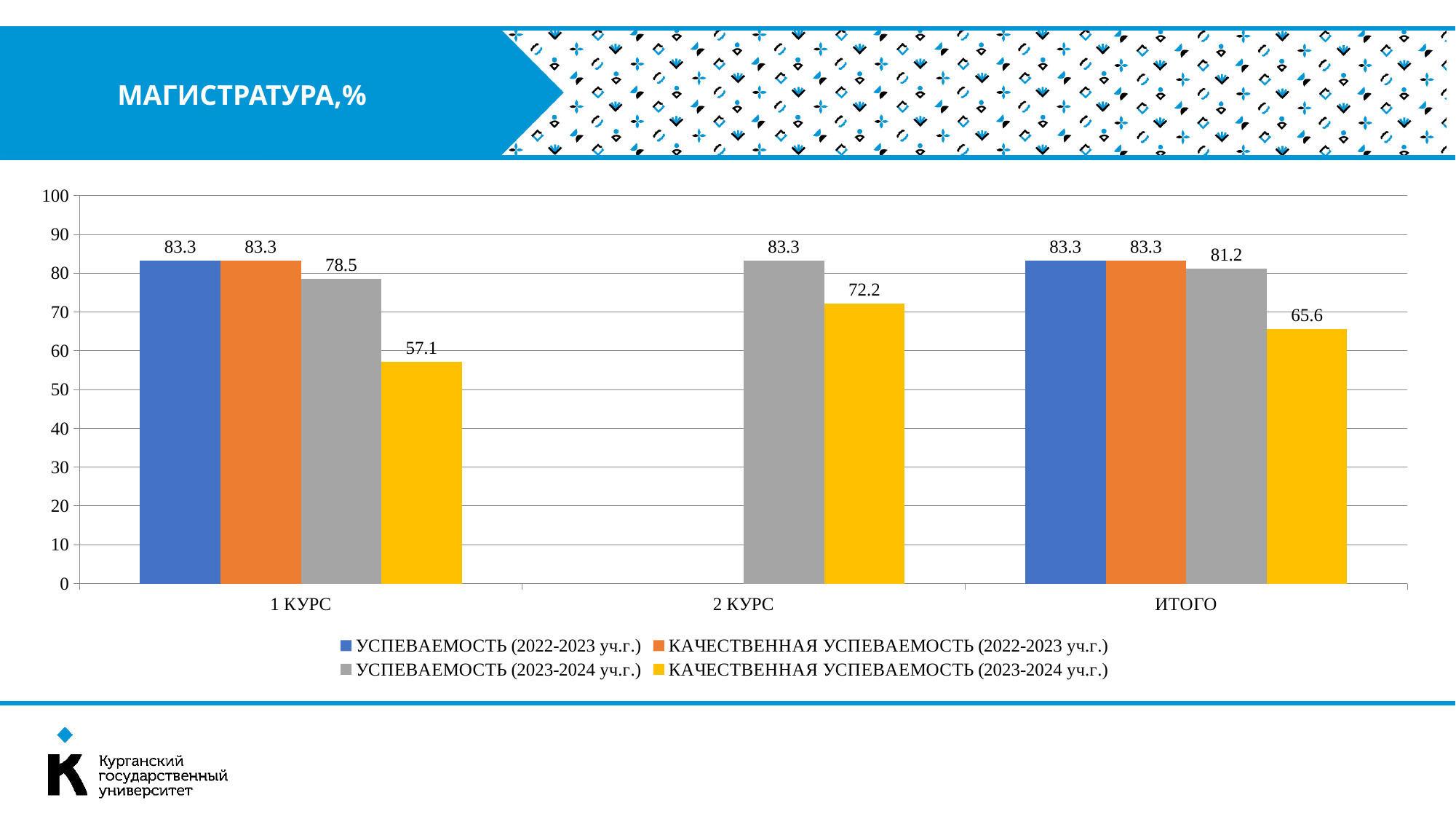
What is the value of КАЧЕСТВЕННАЯ УСПЕВАЕМОСТЬ (2023-2024 уч.г.) for 2 КУРС? 72.2 What kind of chart is shown on the slide? Bar chart What is the value of УСПЕВАЕМОСТЬ (2023-2024 уч.г.) for 2 КУРС? 83.3 Which category has the lowest value for КАЧЕСТВЕННАЯ УСПЕВАЕМОСТЬ (2023-2024 уч.г.)? 1 КУРС Which category has the highest value for КАЧЕСТВЕННАЯ УСПЕВАЕМОСТЬ (2023-2024 уч.г.)? 2 КУРС What is the value of КАЧЕСТВЕННАЯ УСПЕВАЕМОСТЬ (2023-2024 уч.г.) for 1 КУРС? 57.1 How many categories are shown on the x axis? 3 Which is larger for ИТОГО: КАЧЕСТВЕННАЯ УСПЕВАЕМОСТЬ (2022-2023 уч.г.) or КАЧЕСТВЕННАЯ УСПЕВАЕМОСТЬ (2023-2024 уч.г.)? КАЧЕСТВЕННАЯ УСПЕВАЕМОСТЬ (2022-2023 уч.г.) What is the value of УСПЕВАЕМОСТЬ (2023-2024 уч.г.) for ИТОГО? 81.2 What is the difference between УСПЕВАЕМОСТЬ (2022-2023 уч.г.) and УСПЕВАЕМОСТЬ (2023-2024 уч.г.) for ИТОГО? 2.1 How many series does the legend list? 4 What is the difference between УСПЕВАЕМОСТЬ (2023-2024 уч.г.) and КАЧЕСТВЕННАЯ УСПЕВАЕМОСТЬ (2023-2024 уч.г.) for 1 КУРС? 21.4